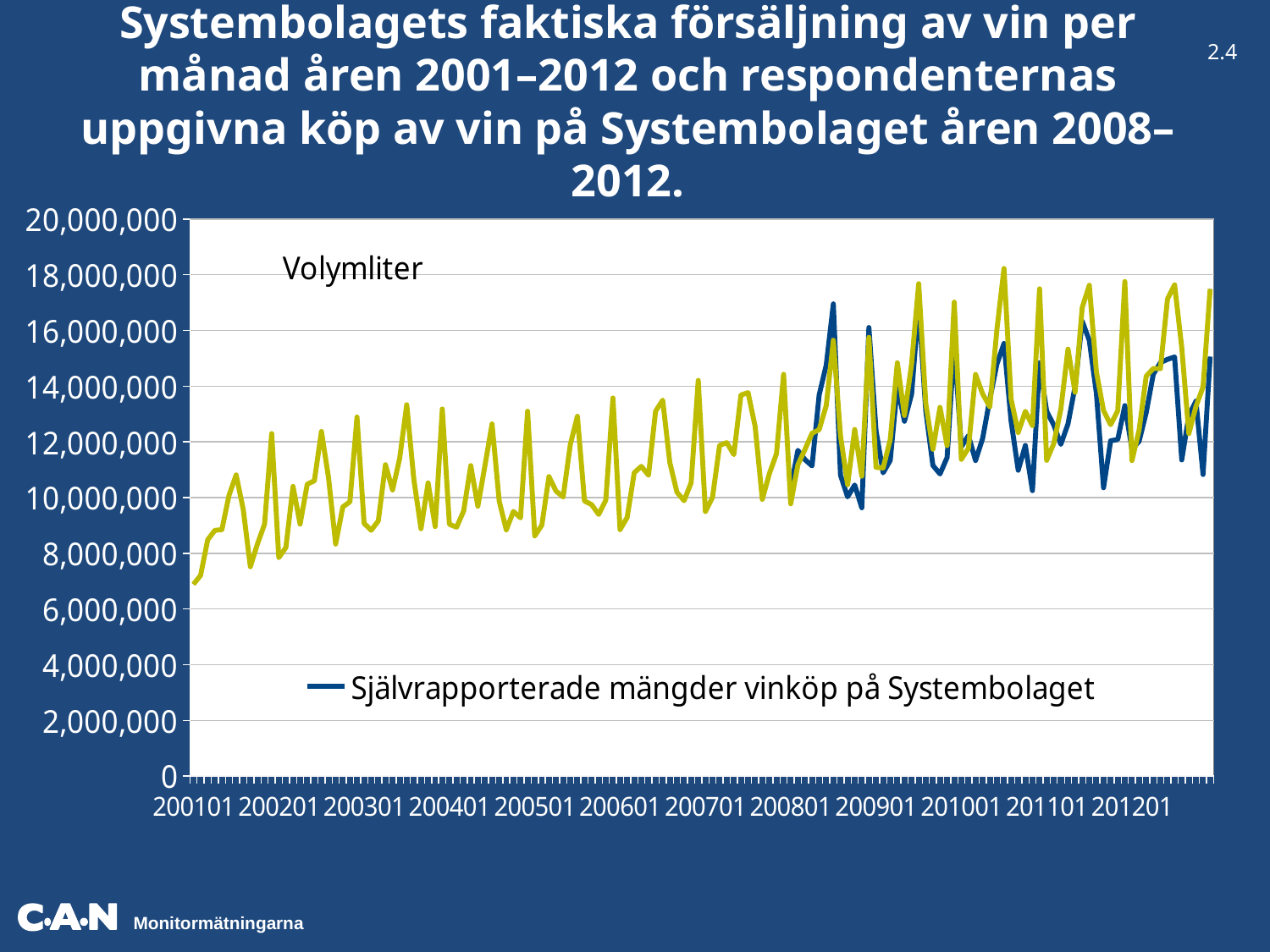
Does the blue line cover the whole period from 200101, or only the later years? only the later years What kind of chart is shown on the slide? line chart Is the value of the yellow line at 200101 greater or less than 8,000,000? less Is the lowest point of the yellow line greater or less than 6,000,000? greater Is the highest peak of the blue line greater or less than 16,000,000? greater Overall, does the yellow line rise or fall from 200101 to 201201? rise How many series does the chart's legend list? 1 What is the maximum value shown on the vertical axis? 20,000,000 What is the title of the chart on the slide? Systembolagets faktiska försäljning av vin per månad åren 2001–2012 och respondenternas uppgivna köp av vin på Systembolaget åren 2008–2012.